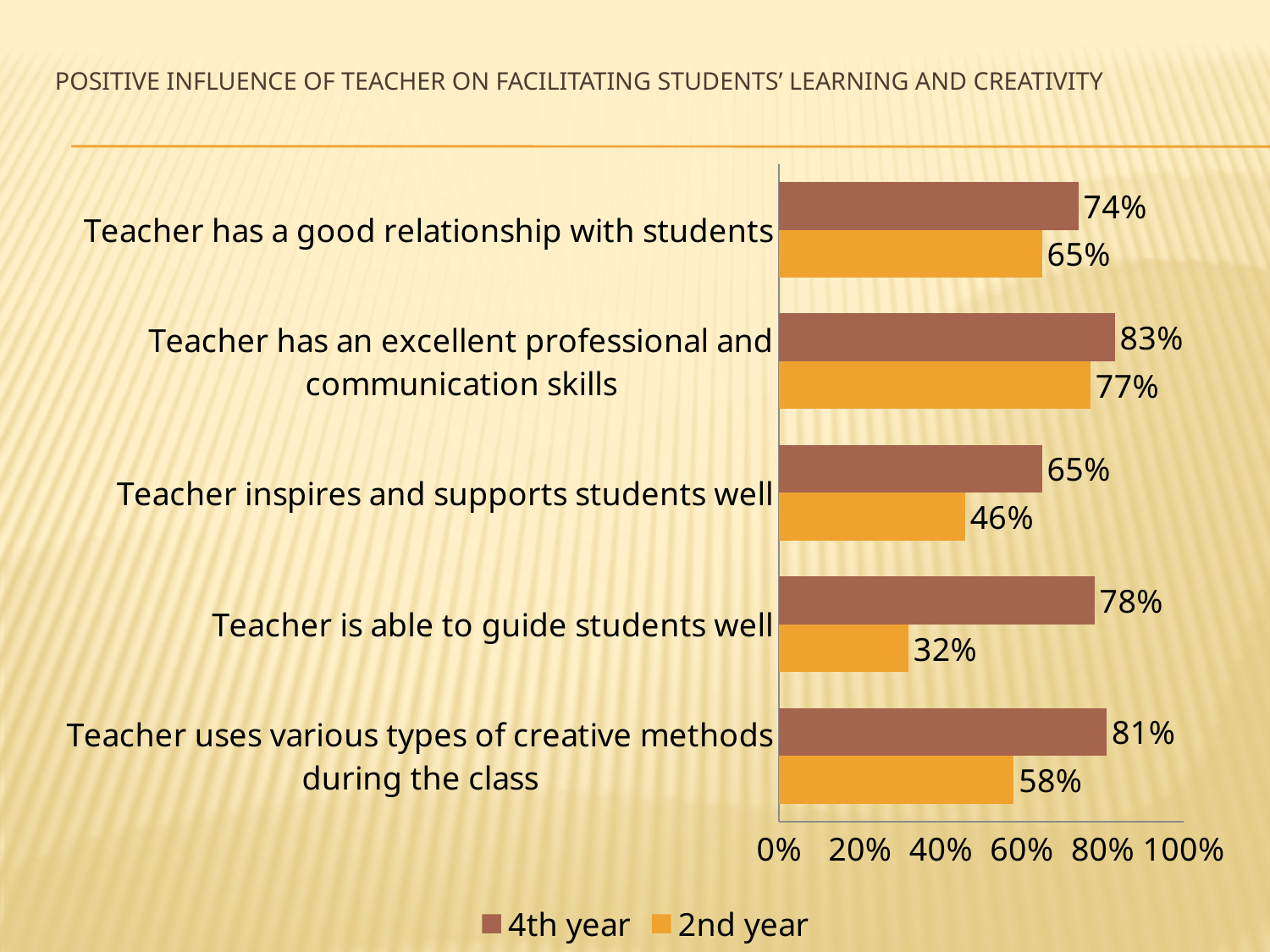
What is the difference between the 4th year and 2nd year values for "Teacher inspires and supports students well"? 19% How many series does the legend list? 2 What is the 2nd year value for "Teacher is able to guide students well"? 32% Which category has the lowest 2nd year value? Teacher is able to guide students well Which category has the highest 4th year value? Teacher has an excellent professional and communication skills What is the difference between the 4th year and 2nd year values for "Teacher is able to guide students well"? 46% What type of chart is shown on the slide? Bar chart What is the 4th year value for "Teacher has a good relationship with students"? 74% Which colour represents the 2nd year series in the legend? Orange What is the 2nd year value for "Teacher uses various types of creative methods during the class"? 58% For "Teacher has an excellent professional and communication skills", which series has the larger value, 4th year or 2nd year? 4th year How many categories are shown in the chart? 5